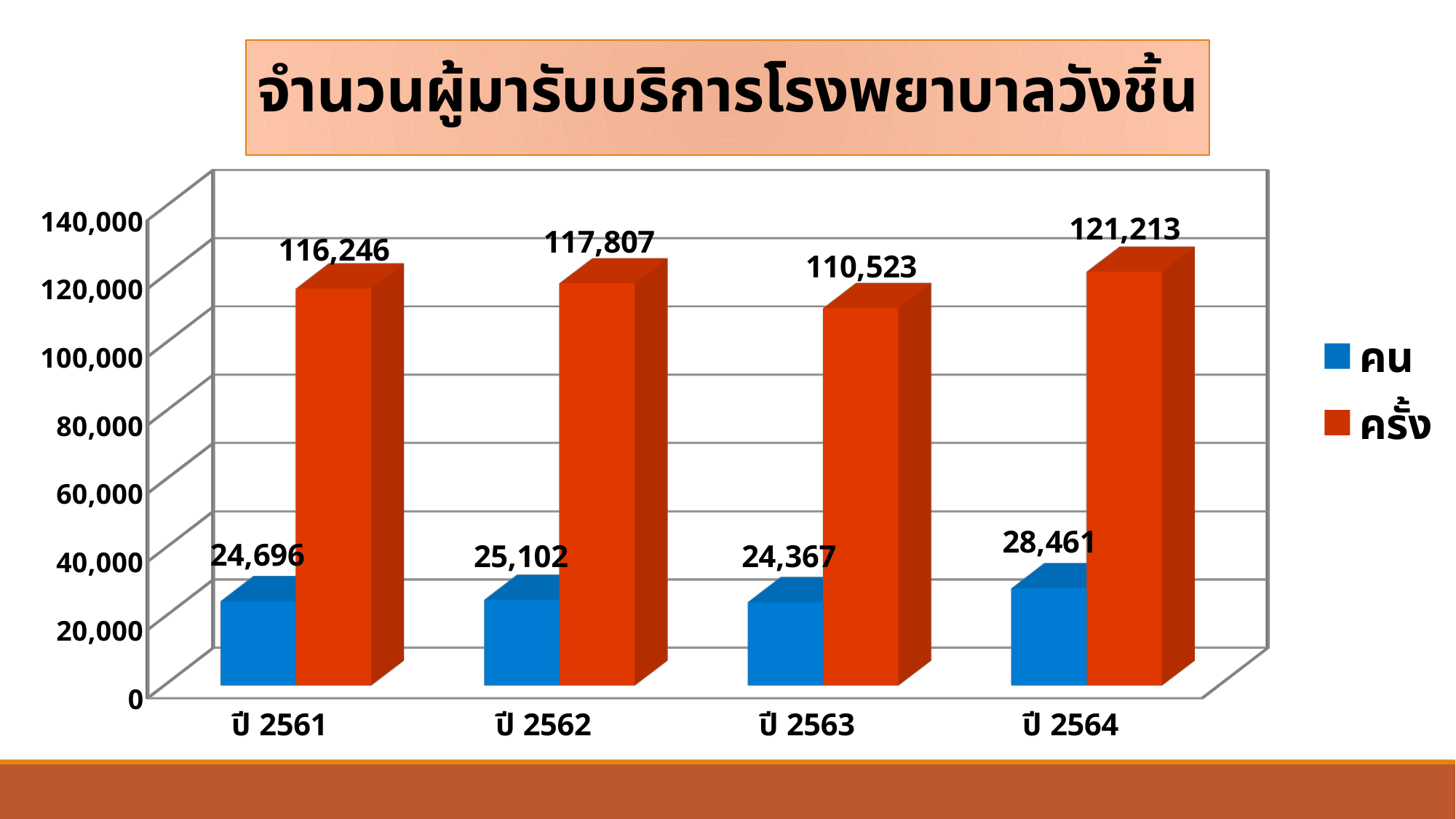
How many series does the legend list? 2 Is the ครั้ง value for ปี 2563 greater or less than 100,000? greater Which year has the highest value for ครั้ง? ปี 2564 What is the value of คน for ปี 2564? 28,461 What is the difference between the ครั้ง values for ปี 2564 and ปี 2563? 10,690 Which is larger, the ครั้ง value for ปี 2561 or for ปี 2562? ปี 2562 What is the value of คน for ปี 2561? 24,696 How many years are shown on the x axis? 4 What is the value of ครั้ง for ปี 2562? 117,807 What kind of chart is shown on the slide? bar chart Which year has the lowest value for คน? ปี 2563 What is the difference between the คน values for ปี 2564 and ปี 2563? 4,094